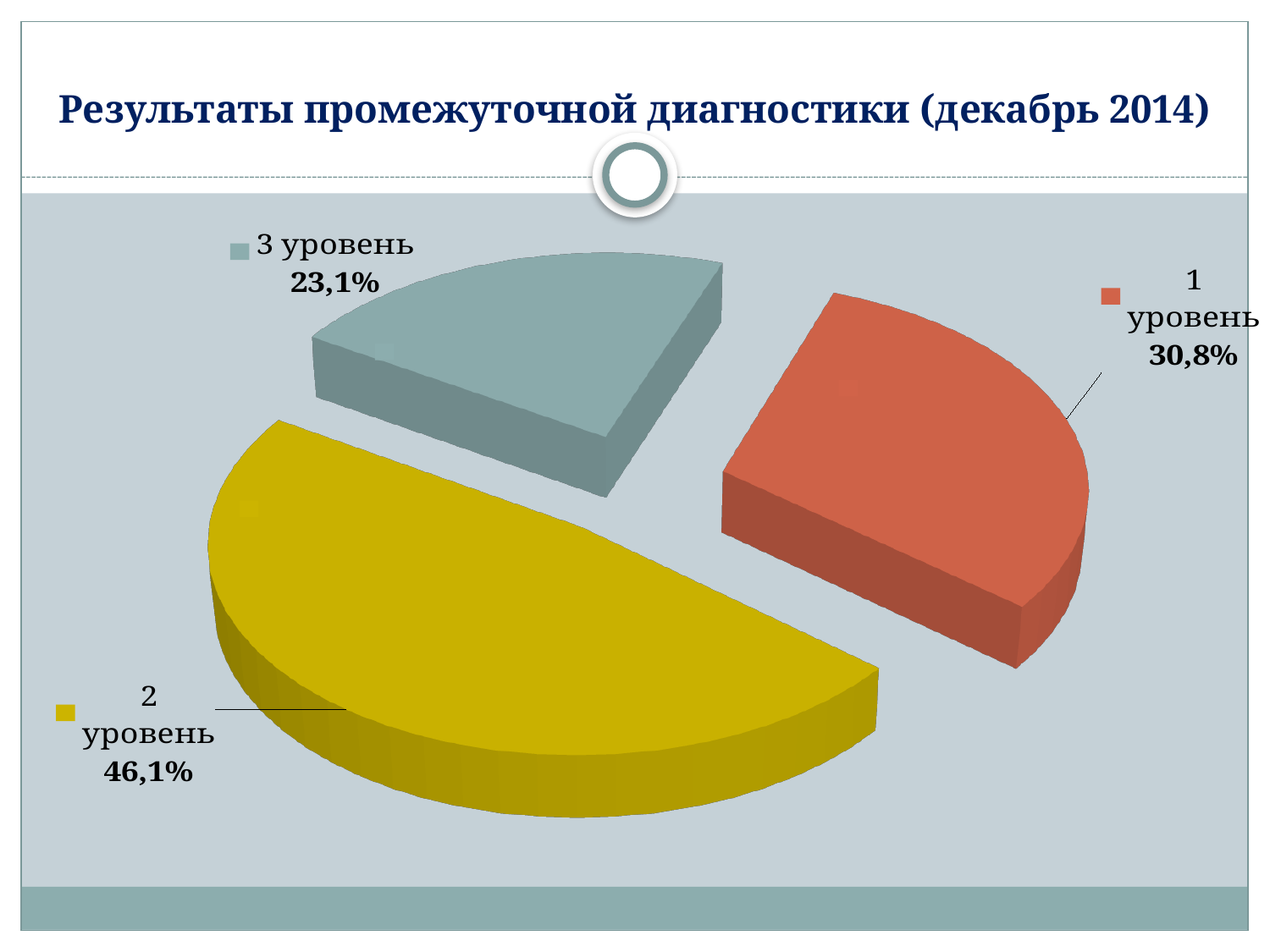
What is the difference between the values for 2 уровень and 1 уровень? 15,3% What kind of chart is shown on the slide? pie chart Which category has the largest share of the pie? 2 уровень What is the difference between the values for 1 уровень and 3 уровень? 7,7% What is the value for 3 уровень? 23,1% Which is larger, the value for 1 уровень or the value for 3 уровень? 1 уровень What is the title of the slide? Результаты промежуточной диагностики (декабрь 2014) How many slices does the pie chart have? 3 What is the value for 1 уровень? 30,8% What is the value for 2 уровень? 46,1% Which category has the smallest share of the pie? 3 уровень What colour is the slice for 2 уровень? yellow